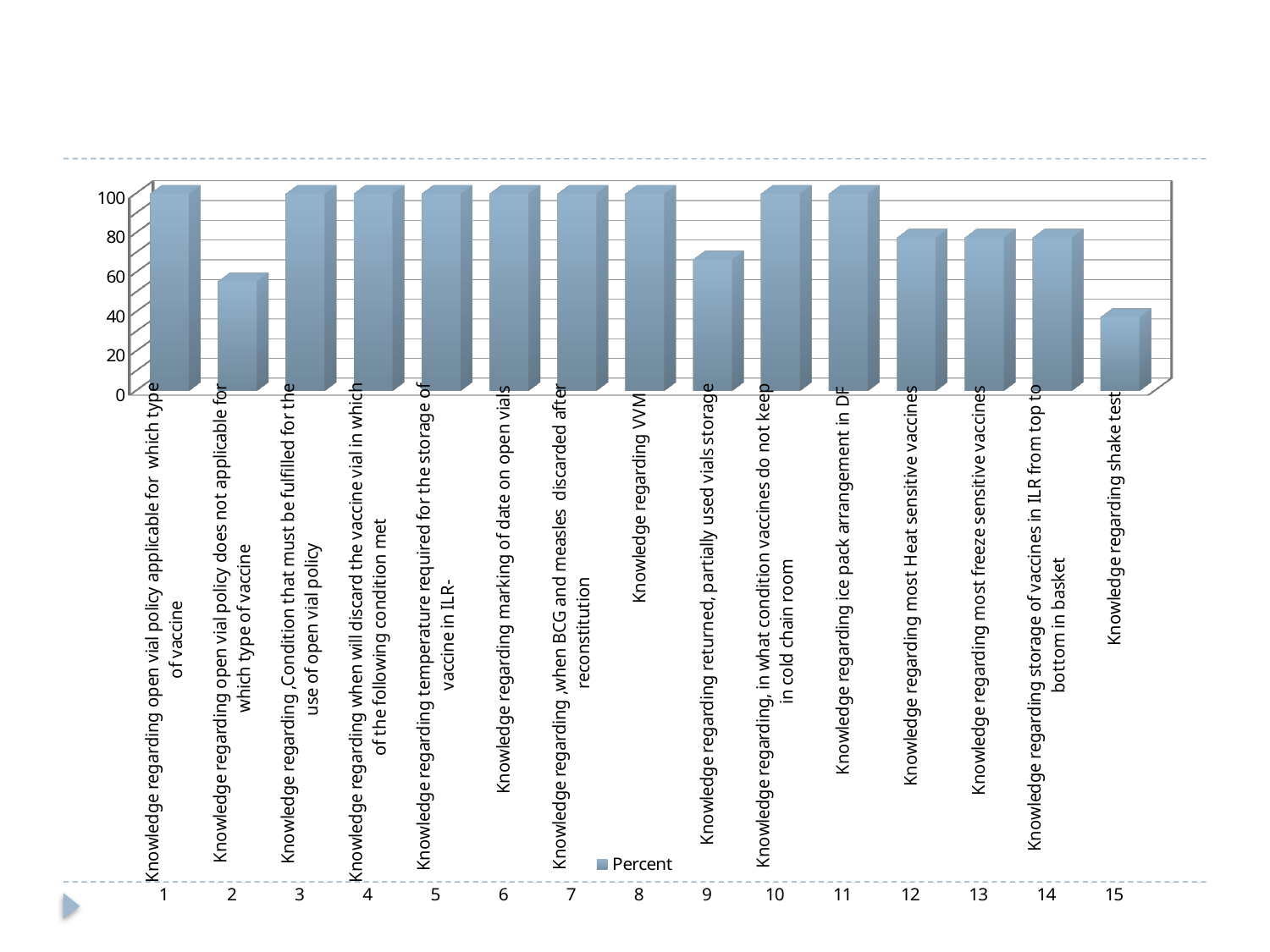
Which is larger: the value for 'Knowledge regarding VVM' or the value for 'Knowledge regarding shake test'? Knowledge regarding VVM What is the name of the series shown in the legend? Percent Is the value for 'Knowledge regarding ice pack arrangement in DF' greater or less than 80? greater Which is larger: the value for 'Knowledge regarding most Heat sensitive vaccines' or the value for 'Knowledge regarding shake test'? Knowledge regarding most Heat sensitive vaccines Is the value for 'Knowledge regarding open vial policy does not applicable for which type of vaccine' greater or less than 80? less What is the value for 'Knowledge regarding VVM'? 100 What kind of chart is shown on the slide? bar chart Is the value for 'Knowledge regarding returned, partially used vials storage' greater or less than 80? less How many series does the legend list? 1 How many categories are plotted on the chart? 15 Which category has the lowest value on the chart? Knowledge regarding shake test